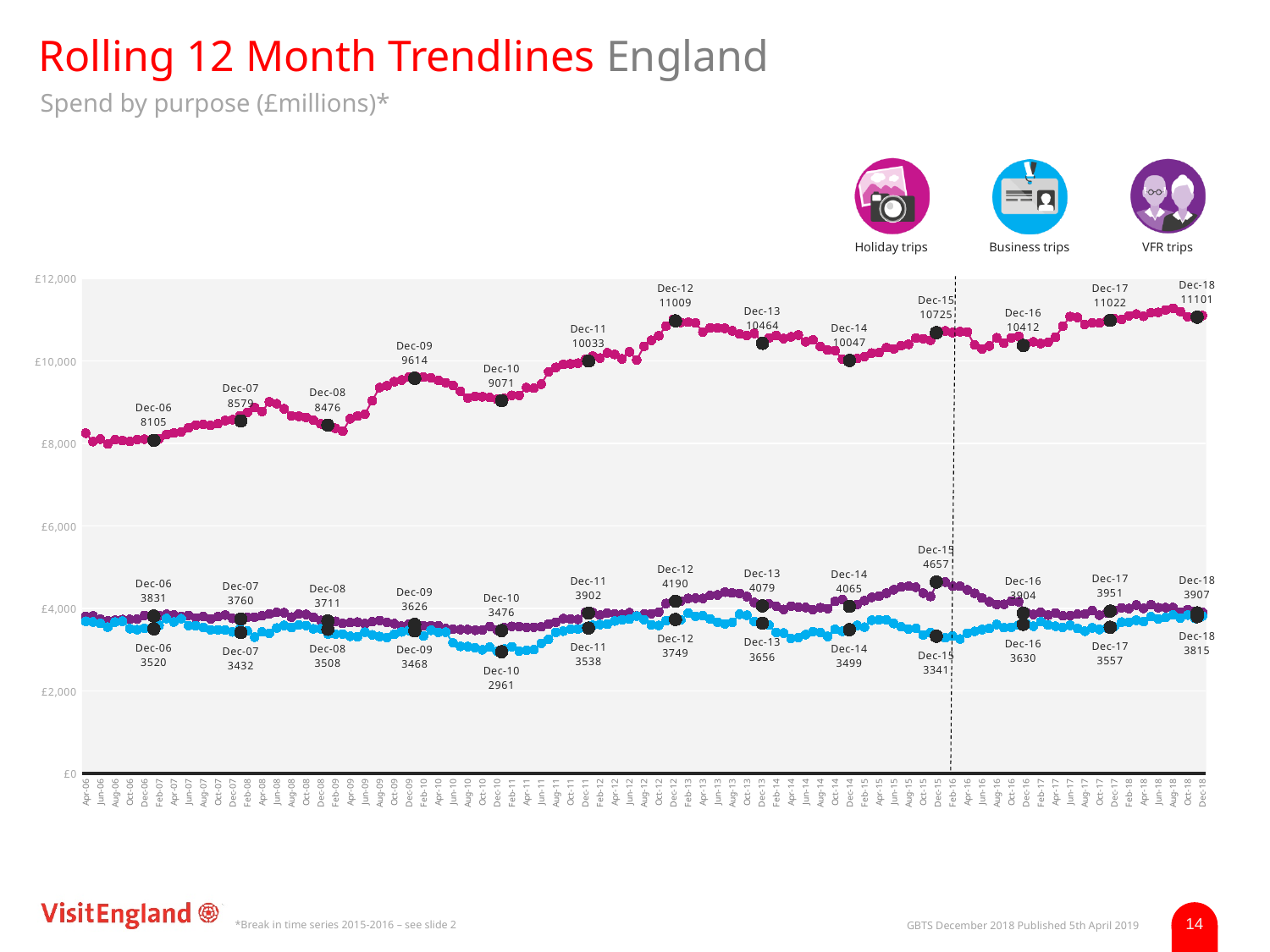
Which is larger, the VFR trips spend at Dec-12 or at Dec-13? Dec-12 Among the labelled December points, which December has the lowest Business trips spend? Dec-10 What is the difference between the Holiday trips spend at Dec-18 and at Dec-17? 79 What is the VFR trips spend value labelled at Dec-15? 4657 How many series does the legend list? 3 What is the Holiday trips spend value labelled at Dec-12? 11009 What is the Holiday trips spend value labelled at Dec-06? 8105 What is the Business trips spend value labelled at Dec-10? 2961 What kind of chart is shown on the slide? line chart Is the Holiday trips spend at Dec-09 greater or less than £10,000? less Among the labelled December points, which December has the highest Holiday trips spend? Dec-18 Does the Holiday trips spend generally rise or fall from Dec-06 to Dec-18? rise